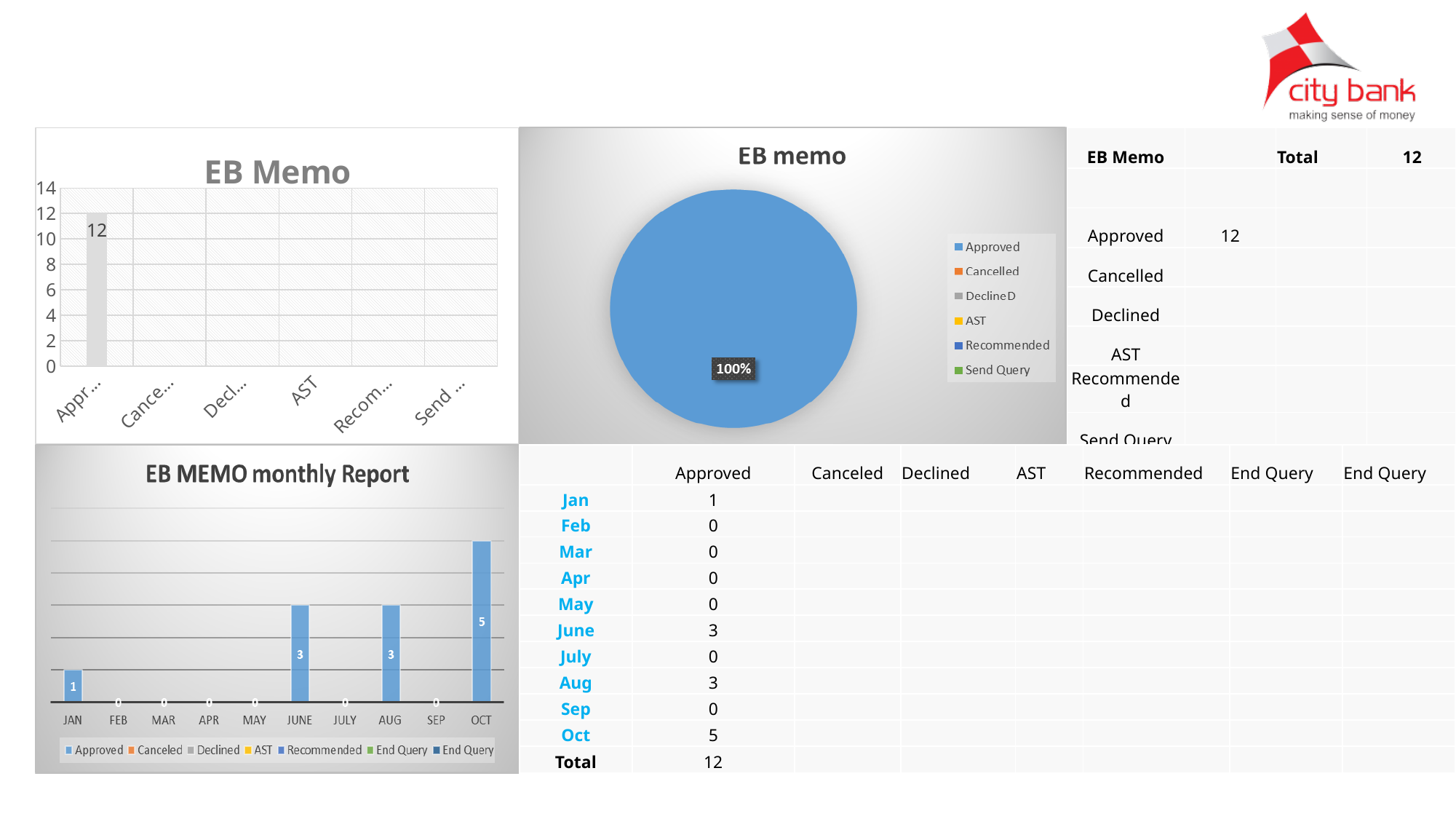
In the 'EB MEMO monthly Report' chart, what is the value for OCT? 5 What kind of chart is the top-left 'EB Memo' chart? Bar chart How many series does the legend of the 'EB MEMO monthly Report' chart list? 7 In the top-left 'EB Memo' chart, what is the value shown for the Approved bar? 12 In the 'EB MEMO monthly Report' chart, what is the value for JAN? 1 In the 'EB MEMO monthly Report' chart, which month has the highest value? OCT In the 'EB MEMO monthly Report' chart, what is the difference between the values for OCT and AUG? 2 In the 'EB MEMO monthly Report' chart, what is the value for JUNE? 3 In the 'EB memo' pie chart, what share is shown for Approved? 100% How many months are shown on the x axis of the 'EB MEMO monthly Report' chart? 10 How many entries does the legend of the 'EB memo' pie chart list? 6 In the 'EB MEMO monthly Report' chart, which is larger, the value for JUNE or the value for JAN? JUNE